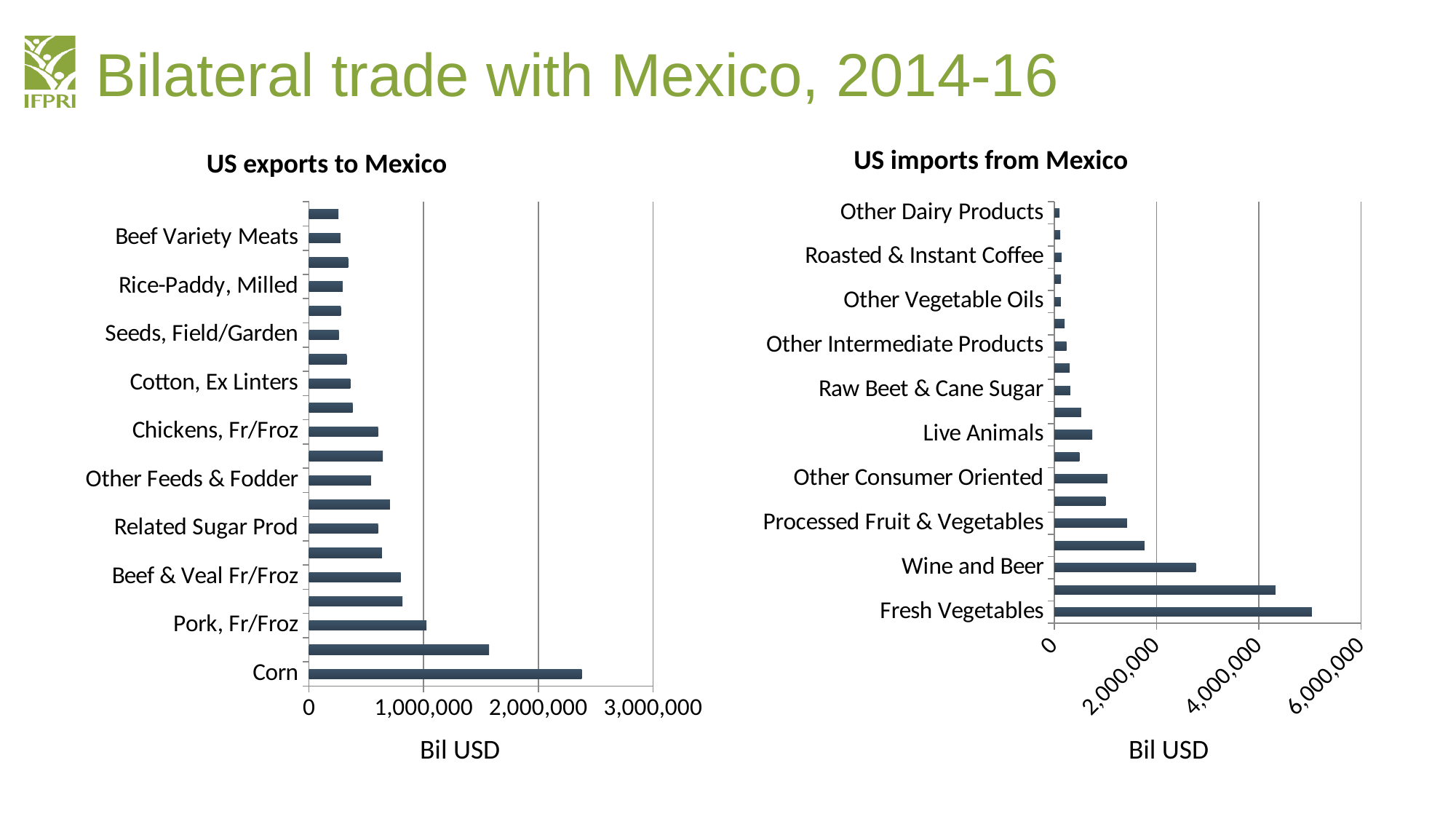
In the 'US exports to Mexico' chart, is the value for Corn greater or less than 2,000,000? greater In the 'US exports to Mexico' chart, is the value for Beef & Veal Fr/Froz greater or less than 1,000,000? less In the 'US exports to Mexico' chart, which is larger, Beef & Veal Fr/Froz or Chickens, Fr/Froz? Beef & Veal Fr/Froz In the 'US imports from Mexico' chart, which is larger, Fresh Vegetables or Wine and Beer? Fresh Vegetables In the 'US exports to Mexico' chart, which is larger, Corn or Pork, Fr/Froz? Corn What kind of chart is the 'US exports to Mexico' chart? bar chart What is the x-axis title of the 'US imports from Mexico' chart? Bil USD In the 'US imports from Mexico' chart, which category has the highest value? Fresh Vegetables In the 'US imports from Mexico' chart, is the value for Live Animals greater or less than 2,000,000? less In the 'US exports to Mexico' chart, which category has the highest value? Corn